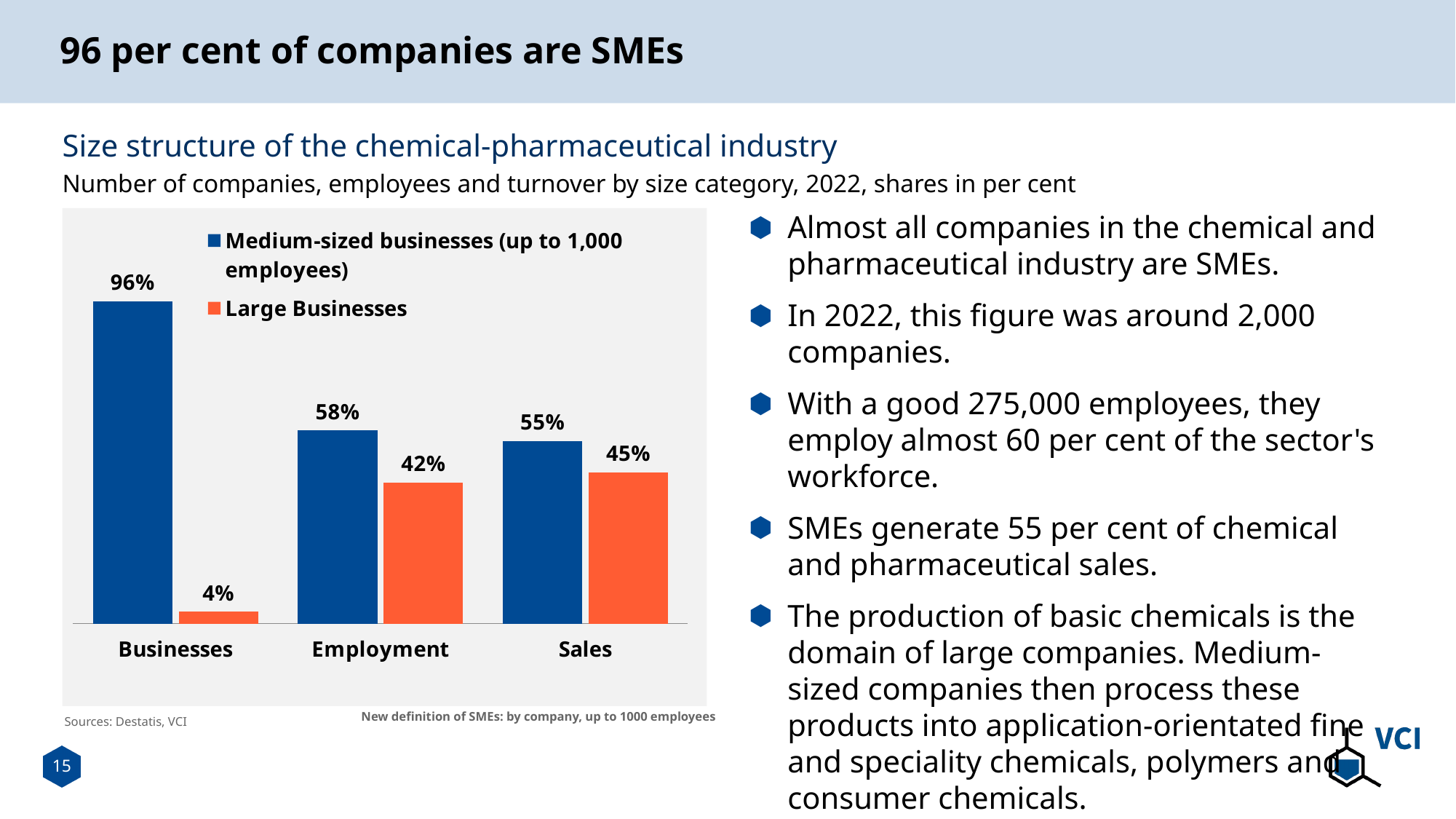
What is the share of medium-sized businesses in the Sales category? 55% What kind of chart is shown on the slide? Bar chart What is the share of large businesses in the Businesses category? 4% How many series does the legend list? 2 What is the share of medium-sized businesses in the Businesses category? 96% In which category is the share of large businesses highest? Sales How many categories are shown on the x axis? 3 What is the difference between the medium-sized and large business shares in the Employment category? 16% Which is larger in the Sales category: the share of medium-sized businesses or the share of large businesses? Medium-sized businesses In which category is the share of medium-sized businesses lowest? Sales What colour are the bars for Large Businesses? Orange What is the share of large businesses in the Employment category? 42%